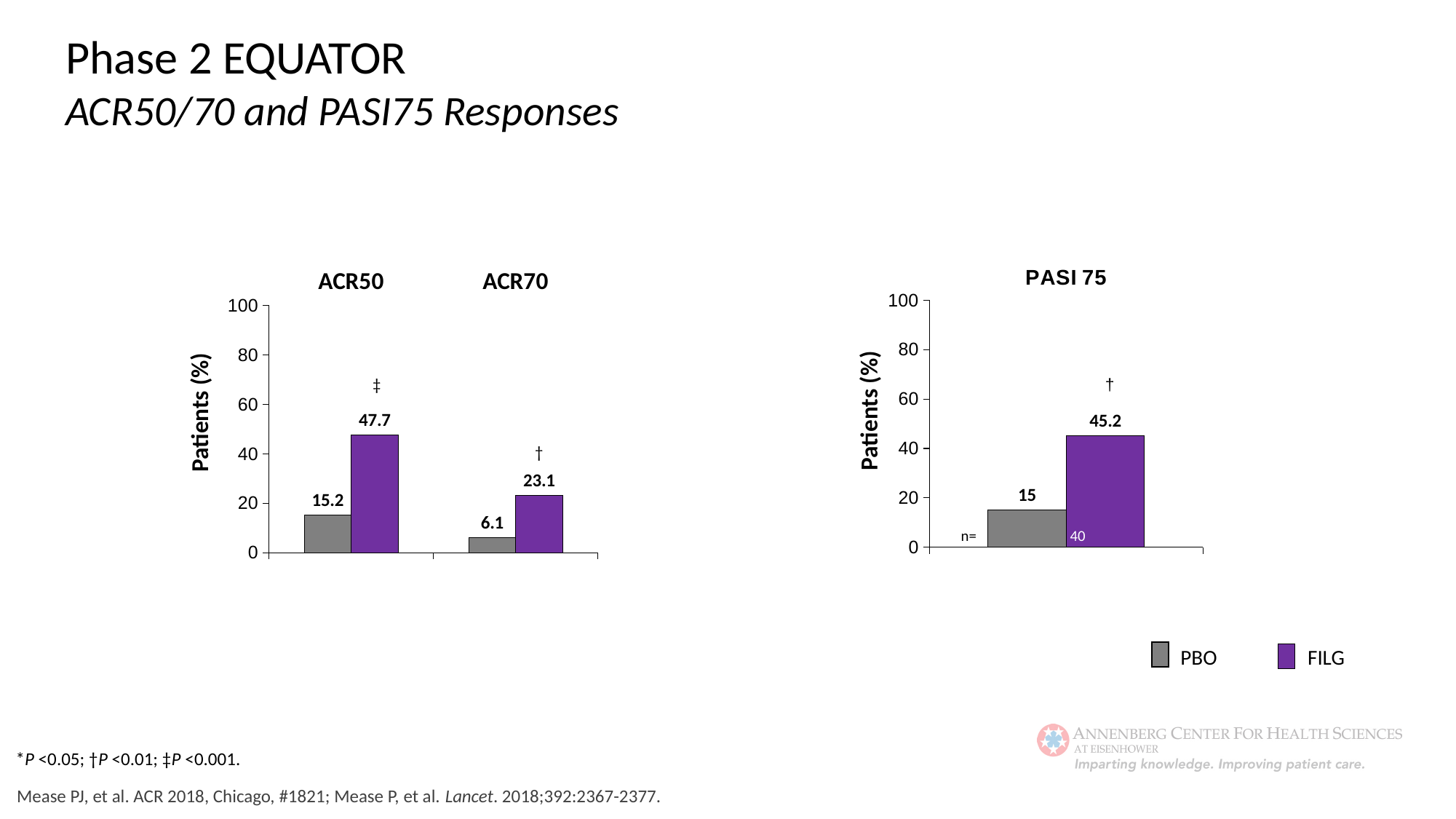
In the left chart (ACR50/ACR70), which bar is the highest? FILG for ACR50 In the left chart (ACR50/ACR70), is the FILG value for ACR70 larger or smaller than the PBO value for ACR50? larger In the left chart (ACR50/ACR70), which bar is the lowest? PBO for ACR70 In the left chart (ACR50/ACR70), what is the FILG value for ACR50? 47.7 In the PASI 75 chart, what is the value for PBO? 15 In the PASI 75 chart, what is the value for FILG? 45.2 In the left chart (ACR50/ACR70), what is the PBO value for ACR70? 6.1 How many series does the legend list? 2 In the PASI 75 chart, is the FILG value greater or less than 40? greater In the PASI 75 chart, what is the difference between the FILG and PBO values? 30.2 In the left chart (ACR50/ACR70), what is the difference between the FILG and PBO values for ACR50? 32.5 What type of chart is the PASI 75 chart? bar chart